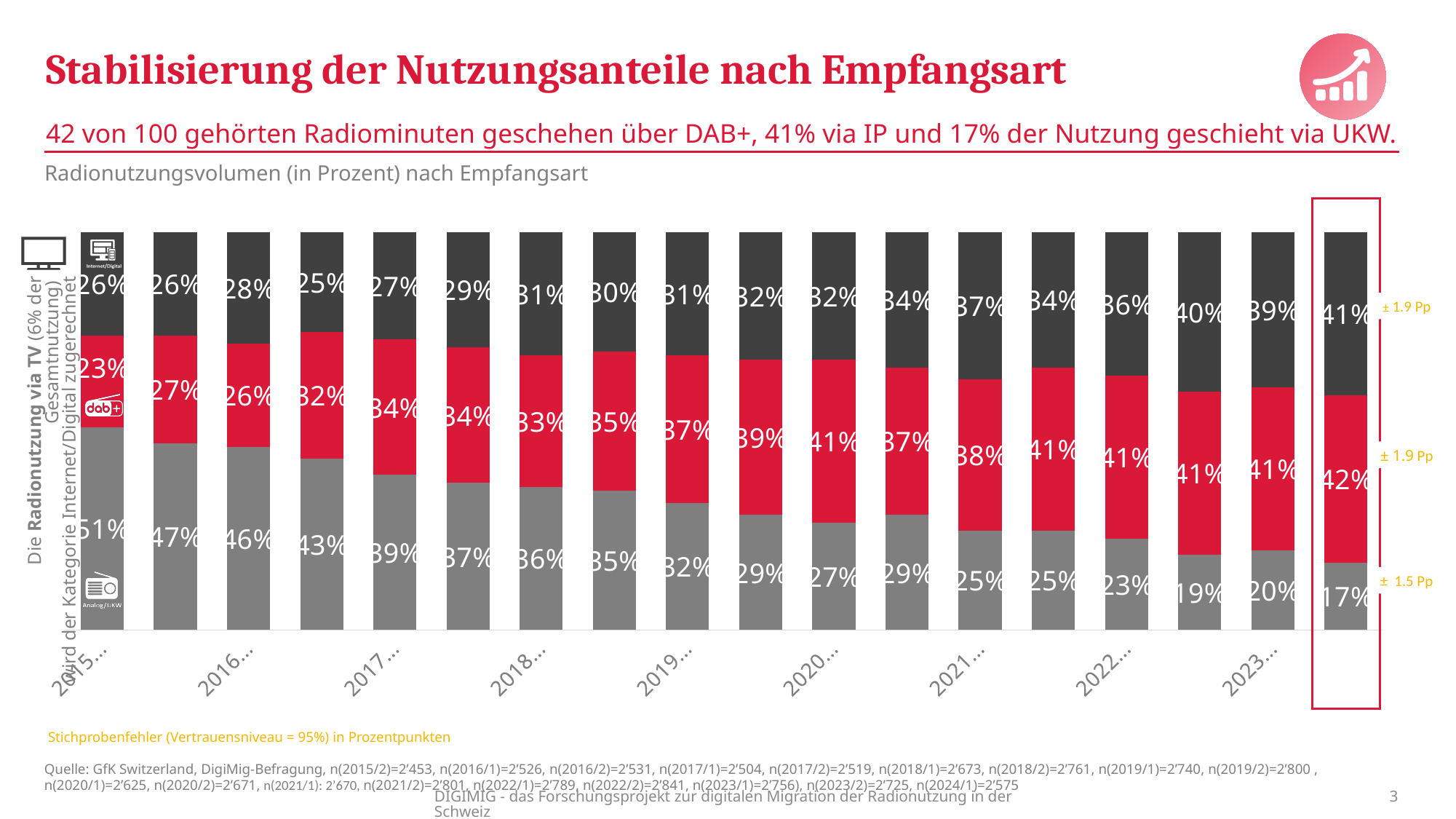
By how many percentage points did the Analog/UKW share drop from the first bar (51%) to the last bar (17%)? 34 percentage points Which reception type has the largest share in the first bar (2015)? Analog/UKW What is the Internet/Digital share in the last, highlighted bar? 41% What is the Analog/UKW share in the last, highlighted bar? 17% What sampling error is shown next to the Analog/UKW segment of the last bar? ± 1.5 Pp What is the DAB+ share in the last, highlighted bar? 42% What kind of chart is shown on the slide? Stacked bar chart What is the Analog/UKW share in the first bar (2015)? 51% How many bars (survey waves) are plotted in the chart? 18 In the first bar (2015), which is larger: the Internet/Digital share or the DAB+ share? Internet/Digital Does the Analog/UKW share rise or fall from the first bar to the last bar? Fall How many reception types (series) are stacked in each bar? 3